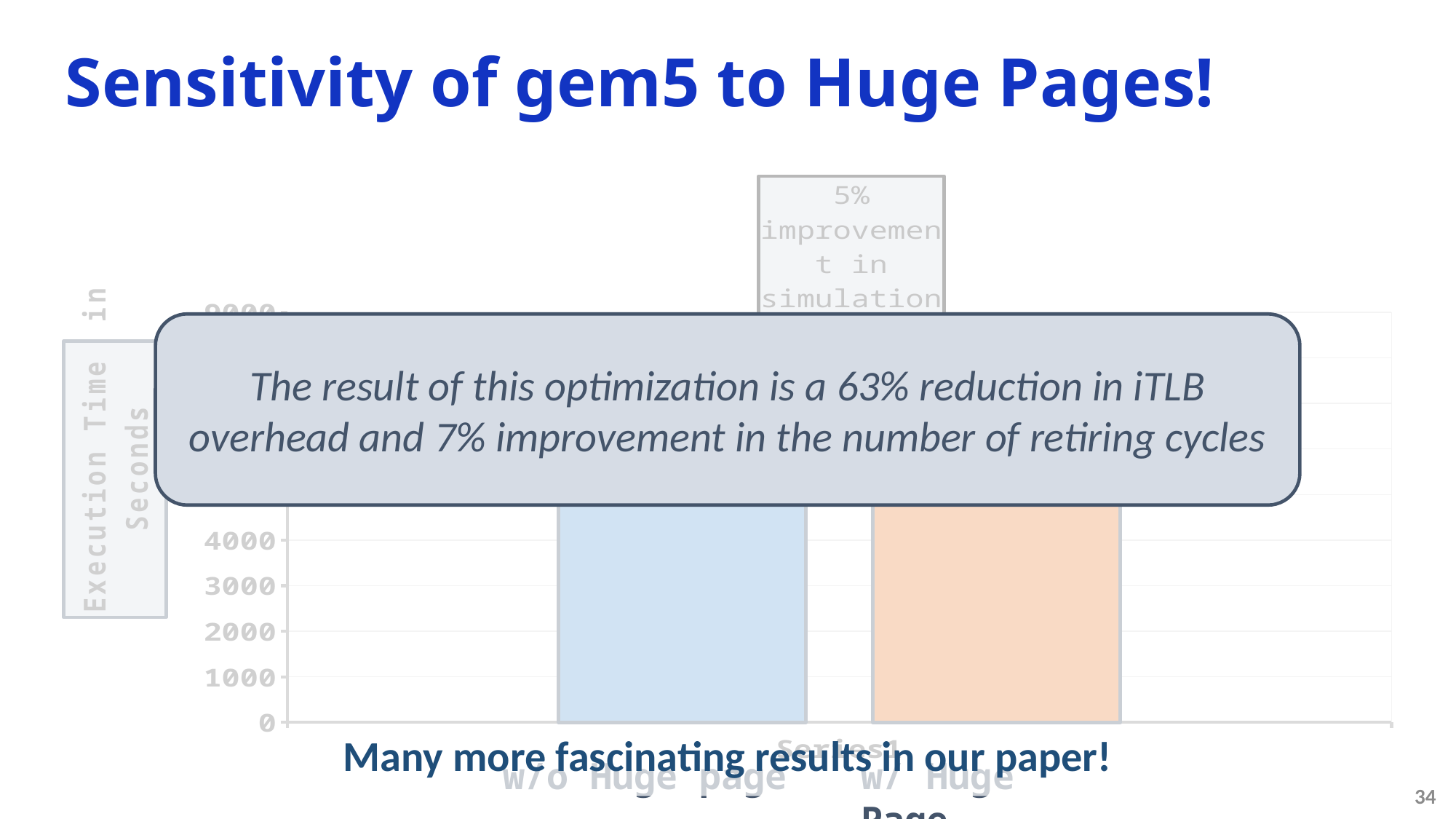
Is the value for w/ Huge Page greater or less than 2000? greater Is the value for w/o Huge page greater or less than 4000? greater Is the value for w/ Huge Page greater or less than 4000? greater What is the label of the y-axis of the chart? Execution Time in Seconds How many bars (categories) does the chart show? 2 What improvement does the annotation above the chart state? 5% improvement in simulation What kind of chart is shown on the slide? bar chart